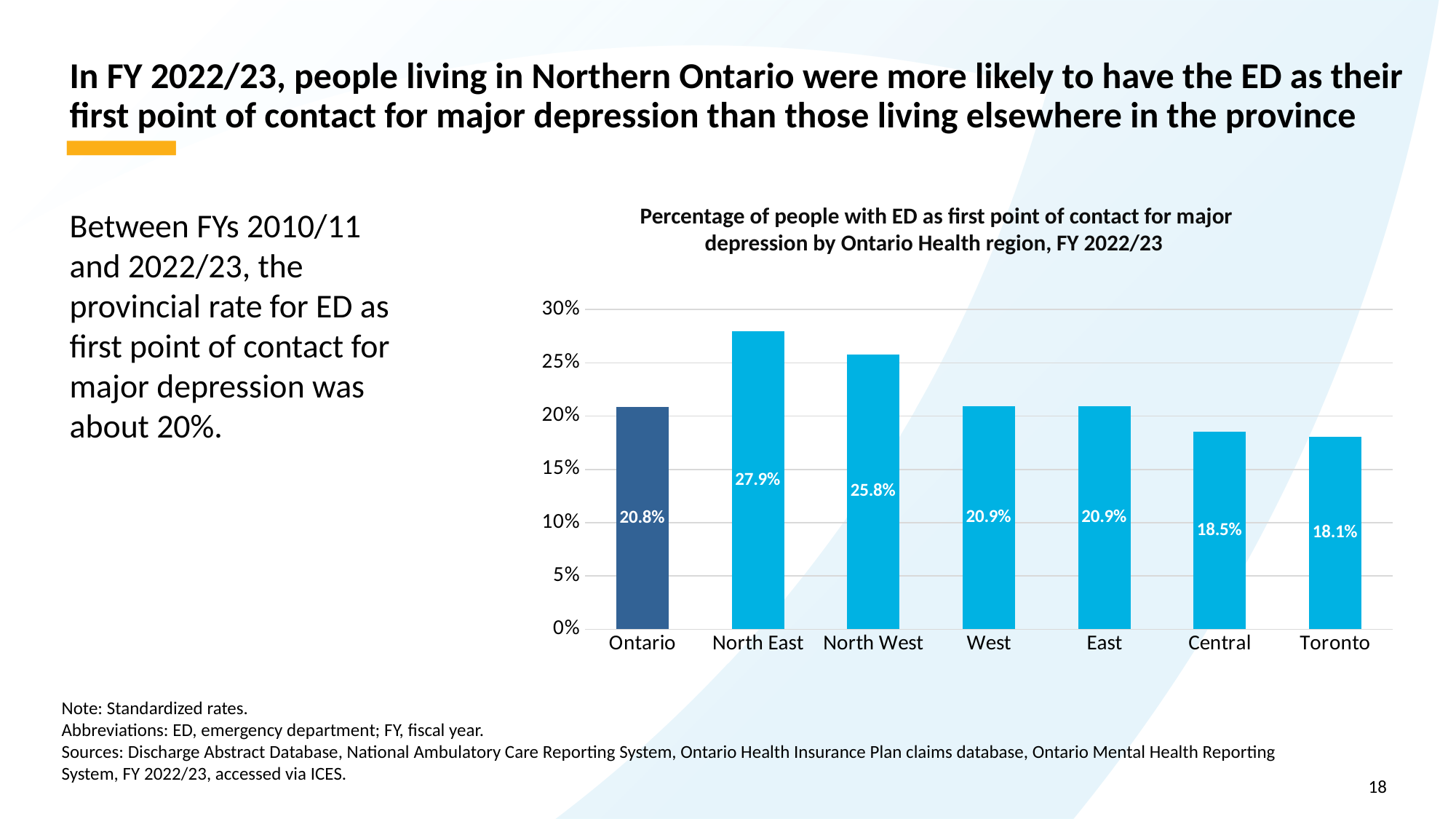
Which is larger, the value for North West or the value for West? North West How many categories are shown on the x axis? 7 What is the title of the chart? Percentage of people with ED as first point of contact for major depression by Ontario Health region, FY 2022/23 Is the value for North East greater or less than 25%? greater What is the difference between the values for North East and North West? 2.1% What is the value for Toronto? 18.1% What is the difference between the values for Central and Toronto? 0.4% Which category has the lowest percentage? Toronto What kind of chart is shown on the slide? Bar chart What is the value for North East? 27.9% Which region has the highest percentage? North East What is the value for Ontario? 20.8%